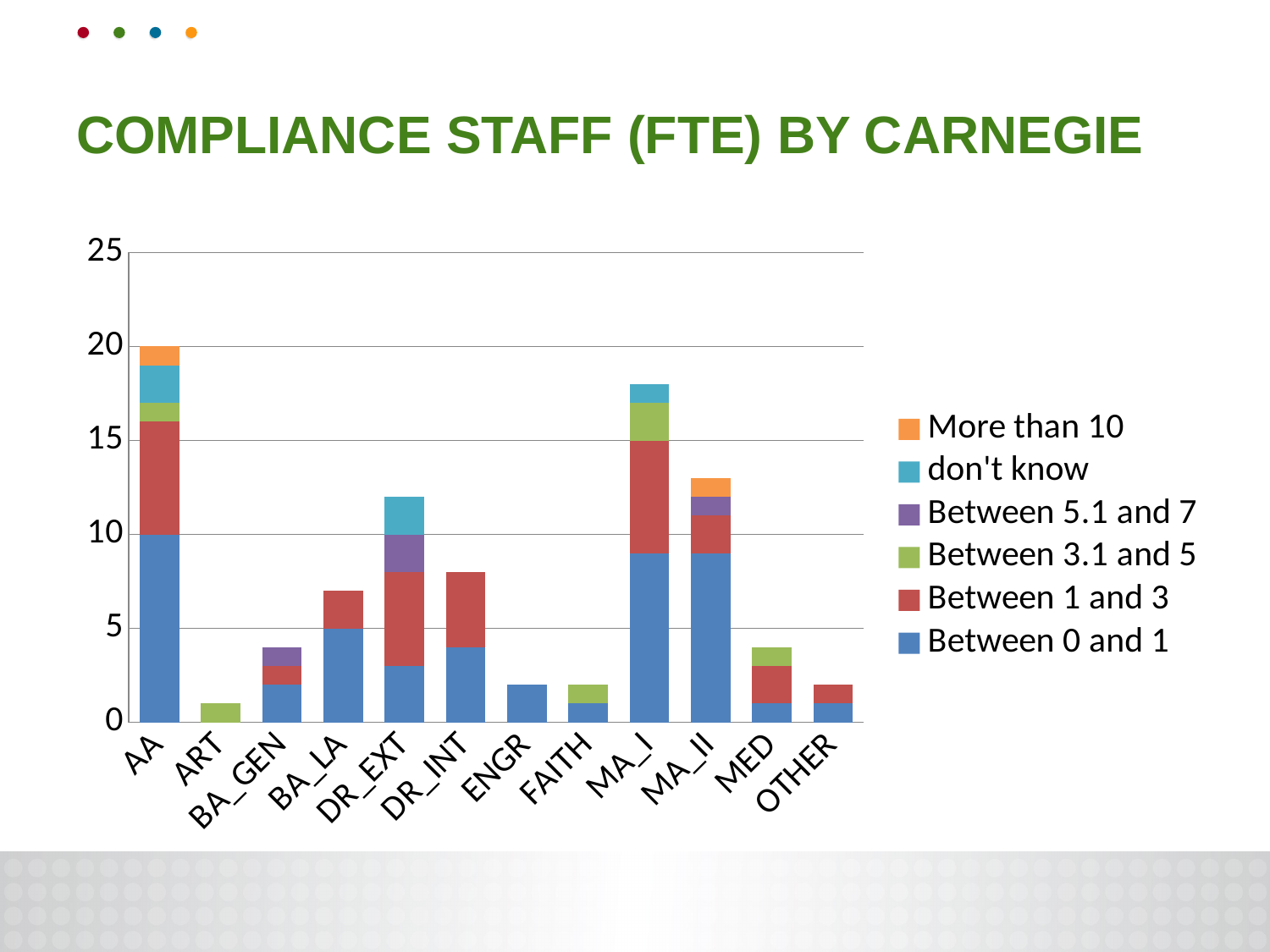
How many series does the legend list? 6 What is the total height of the stacked bar for AA? 20 Which has the larger total, MA_I or DR_EXT? MA_I Is the total for DR_EXT greater or less than 10? greater What type of chart is shown on the slide? Stacked bar chart Is the total for ENGR greater or less than 5? less Which category has the tallest stacked bar? AA What is the title of the chart? COMPLIANCE STAFF (FTE) BY CARNEGIE Is the total for MA_I greater or less than 15? greater Which category has the shortest stacked bar? ART How many Carnegie categories are shown along the x axis? 12